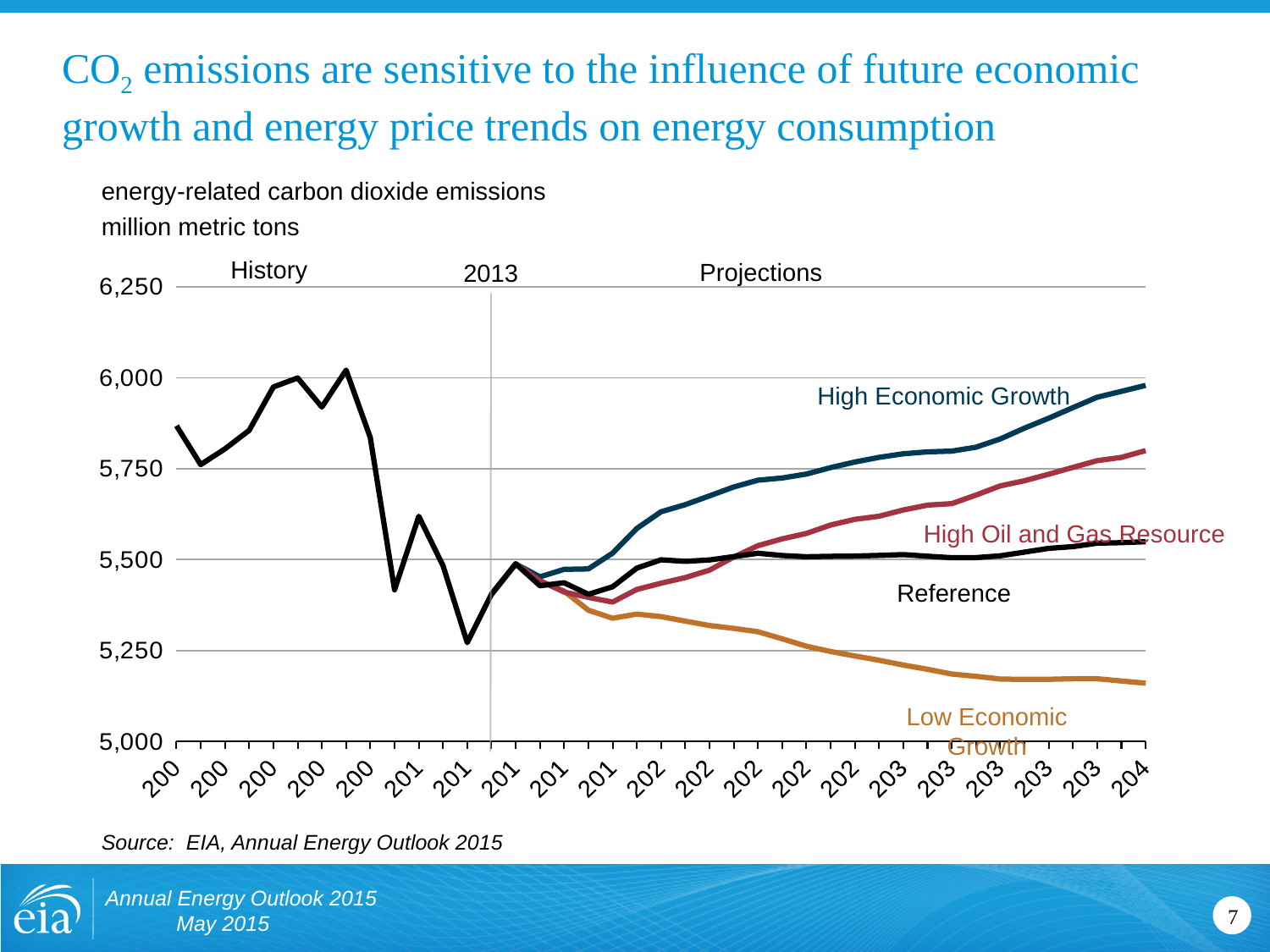
Do emissions in the Low Economic Growth scenario rise or fall over the projection period? fall At the end of the projection period, is the value for High Economic Growth greater or less than 5,750? greater At the end of the projection period, is the value for Low Economic Growth greater or less than 5,250? less At the end of the projection period, is the value for Reference greater or less than 5,750? less Which projection scenario has the highest emissions at the end of the projection period? High Economic Growth What kind of chart is shown on the slide? line chart Which year marks the boundary between History and Projections on the chart? 2013 Do emissions in the High Economic Growth scenario rise or fall over the projection period? rise How many projection scenarios are labeled on the chart? 4 At the end of the projection period, which is larger: High Economic Growth or High Oil and Gas Resource? High Economic Growth In what units are the emissions on the chart measured? million metric tons Which projection scenario has the lowest emissions at the end of the projection period? Low Economic Growth